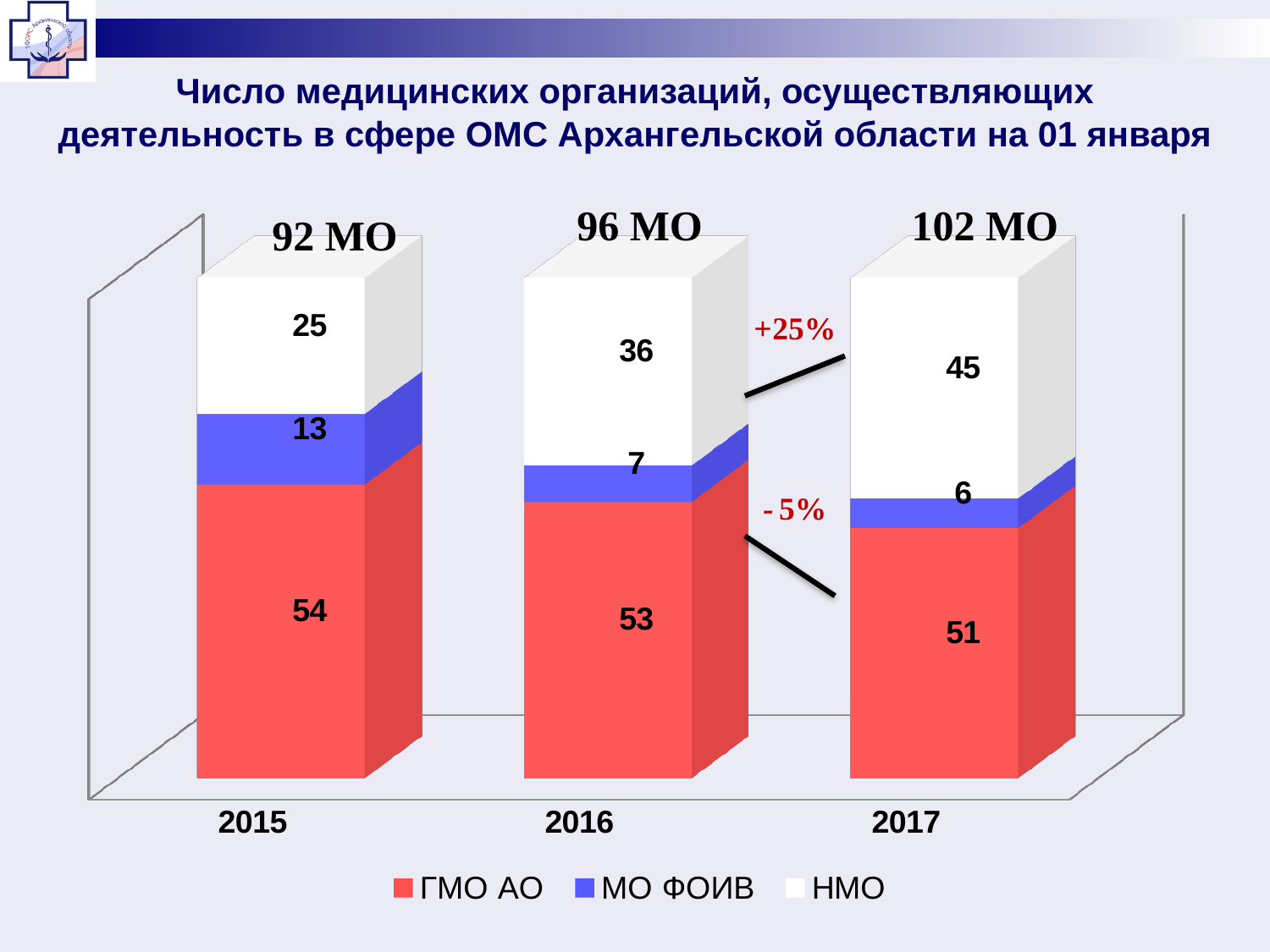
Which year has the lowest value for МО ФОИВ? 2017 Does the value for ГМО АО rise or fall from 2015 to 2017? fall How many years are shown on the x axis? 3 How many series does the legend list? 3 What kind of chart is shown on the slide? stacked bar chart Which year has the highest value for НМО? 2017 What is the value for ГМО АО in 2015? 54 What is the total of the stacked bar for 2016? 96 What is the difference between the НМО values for 2017 and 2015? 20 Which is larger, the ГМО АО value for 2015 or for 2017? 2015 What is the value for НМО in 2017? 45 What is the value for МО ФОИВ in 2016? 7